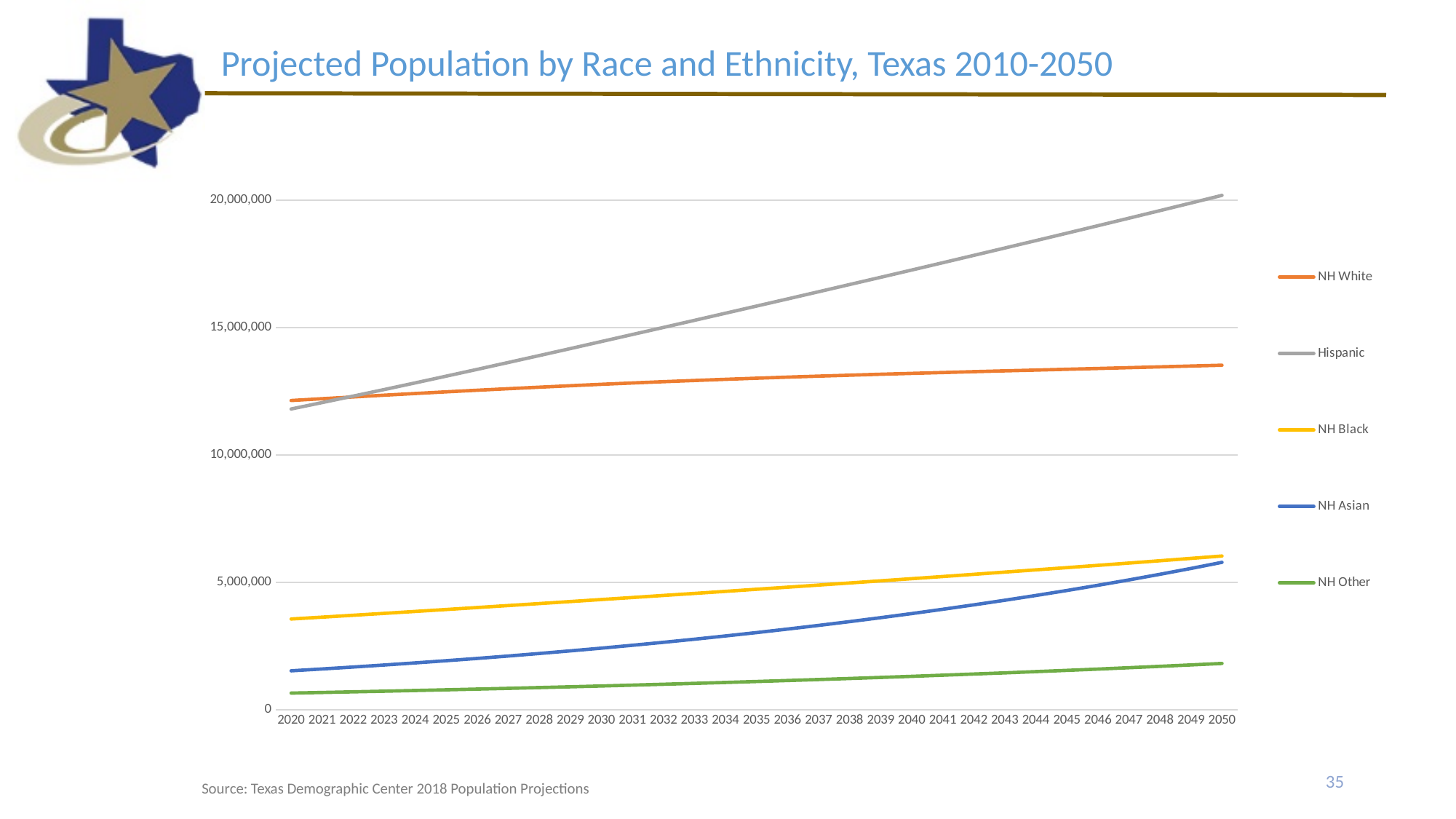
What is the title of the chart? Projected Population by Race and Ethnicity, Texas 2010-2050 Is the Hispanic population in 2020 greater or less than 15,000,000? less Which series has the lowest projected population in 2050? NH Other How many series does the legend list? 5 Is the NH Asian population in 2050 greater or less than 5,000,000? greater Does the Hispanic population rise or fall from 2020 to 2050? rise What kind of chart is shown on the slide? Line chart Is the NH White population in 2050 greater or less than 15,000,000? less In 2050, which is larger: the NH Black population or the NH Asian population? NH Black In 2020, which is larger: the NH White population or the Hispanic population? NH White How many years are shown along the x axis? 31 Which series has the highest projected population in 2050? Hispanic